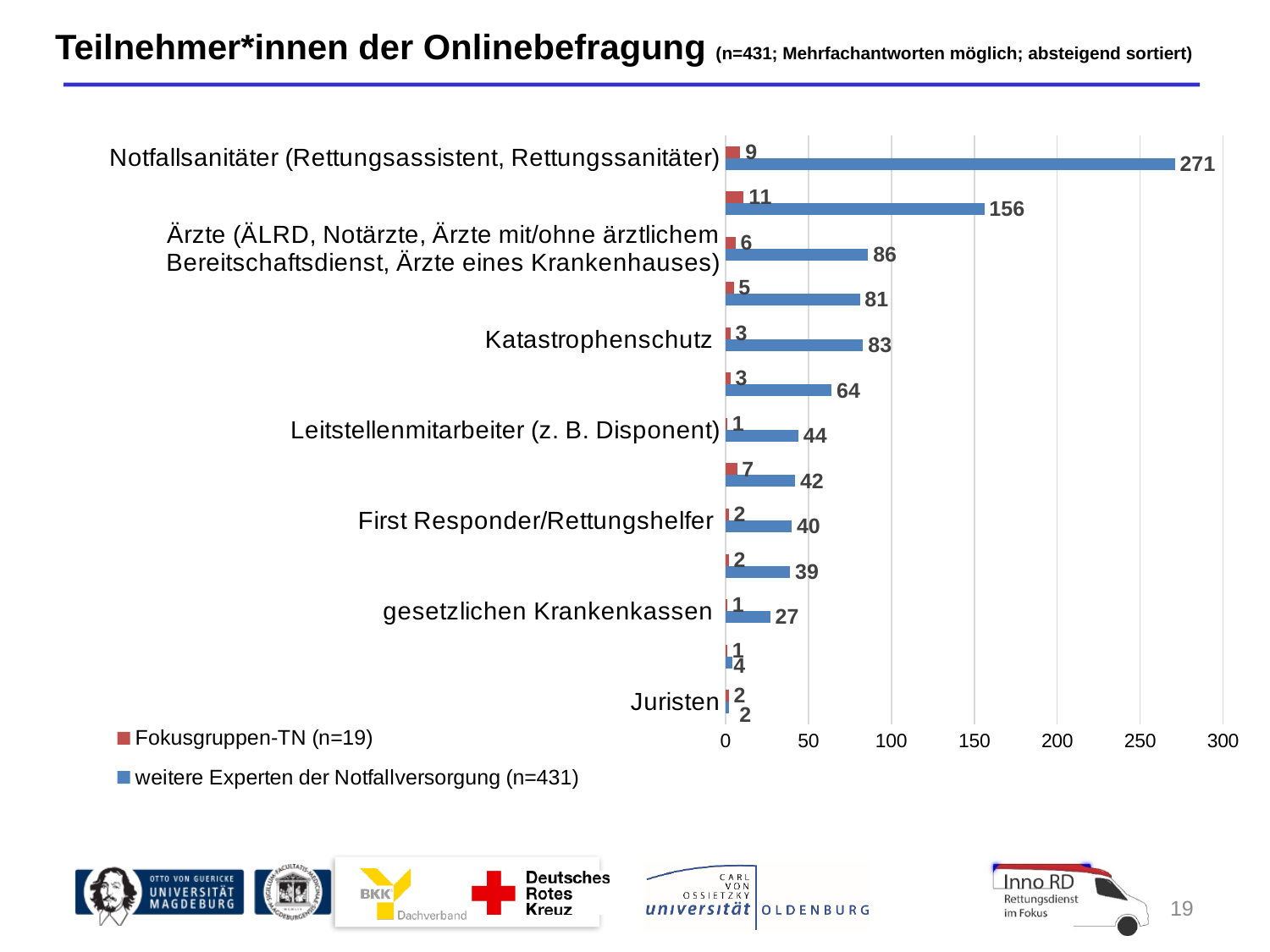
What type of chart is shown on the slide? bar chart What is the difference between the 'weitere Experten der Notfallversorgung (n=431)' values for Katastrophenschutz and Leitstellenmitarbeiter (z. B. Disponent)? 39 How many series does the legend list? 2 What is the value for gesetzlichen Krankenkassen in the series 'weitere Experten der Notfallversorgung (n=431)'? 27 How many categories (bar pairs) are plotted in the chart? 13 What is the value for First Responder/Rettungshelfer in the series 'Fokusgruppen-TN (n=19)'? 2 What is the value for Notfallsanitäter (Rettungsassistent, Rettungssanitäter) in the series 'weitere Experten der Notfallversorgung (n=431)'? 271 What is the value for Katastrophenschutz in the series 'weitere Experten der Notfallversorgung (n=431)'? 83 What is the value for Leitstellenmitarbeiter (z. B. Disponent) in the series 'weitere Experten der Notfallversorgung (n=431)'? 44 Which has a larger 'weitere Experten der Notfallversorgung (n=431)' value: First Responder/Rettungshelfer or gesetzlichen Krankenkassen? First Responder/Rettungshelfer Which category has the highest value in the series 'weitere Experten der Notfallversorgung (n=431)'? Notfallsanitäter (Rettungsassistent, Rettungssanitäter) What is the value for Notfallsanitäter (Rettungsassistent, Rettungssanitäter) in the series 'Fokusgruppen-TN (n=19)'? 9